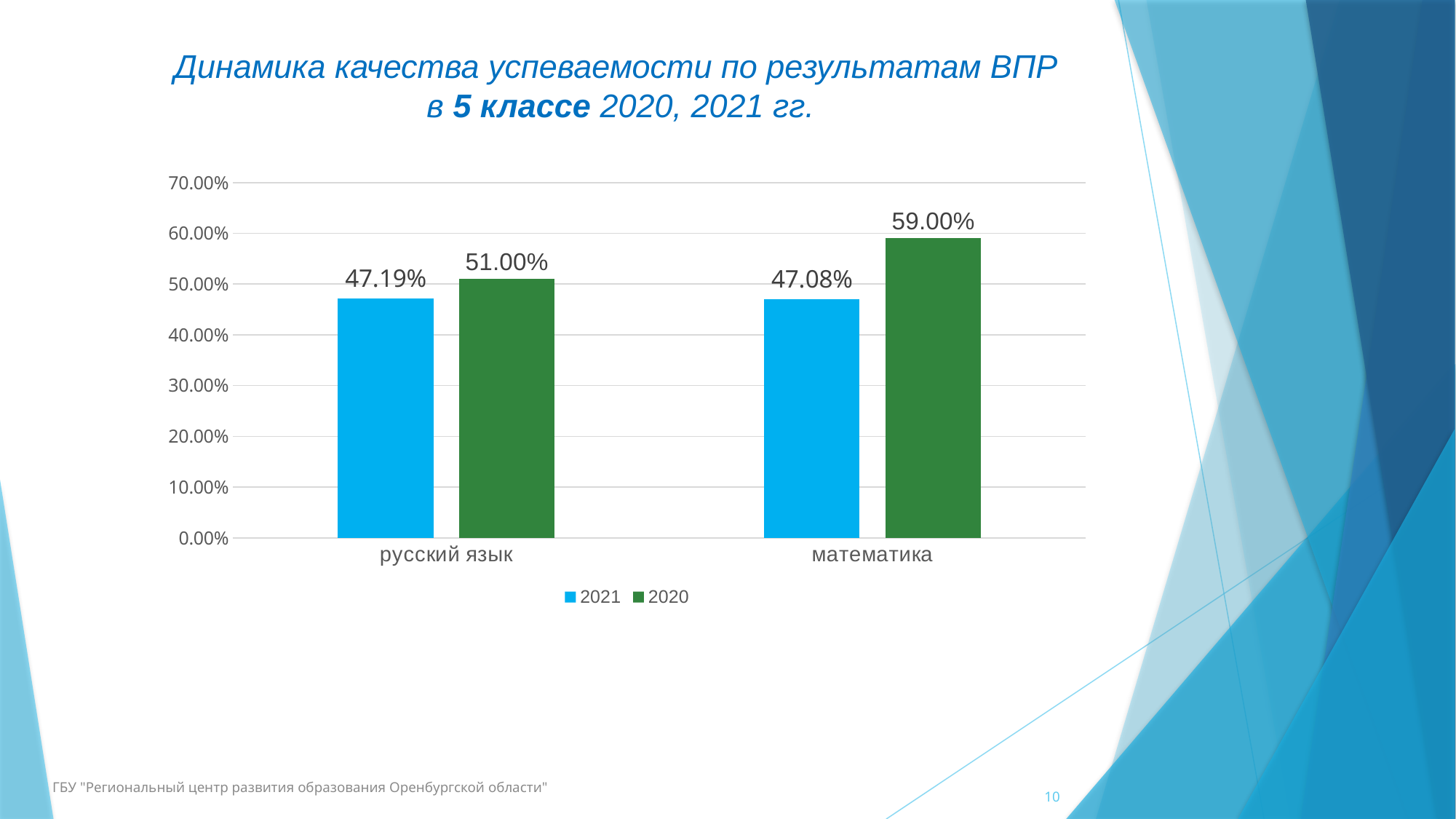
What is the difference between the 2020 and 2021 values for русский язык? 3.81% How many series does the legend list? 2 What is the difference between the 2020 and 2021 values for математика? 11.92% Which subject has the highest value in the 2020 series? математика What type of chart is shown on the slide? bar chart What is the value for русский язык in 2020? 51.00% How many subject categories are shown on the x axis? 2 Which is larger for русский язык: the 2020 value or the 2021 value? 2020 Is the value for математика in 2020 greater or less than 50.00%? greater What is the value for математика in 2021? 47.08% What is the value for математика in 2020? 59.00% What is the value for русский язык in 2021? 47.19%